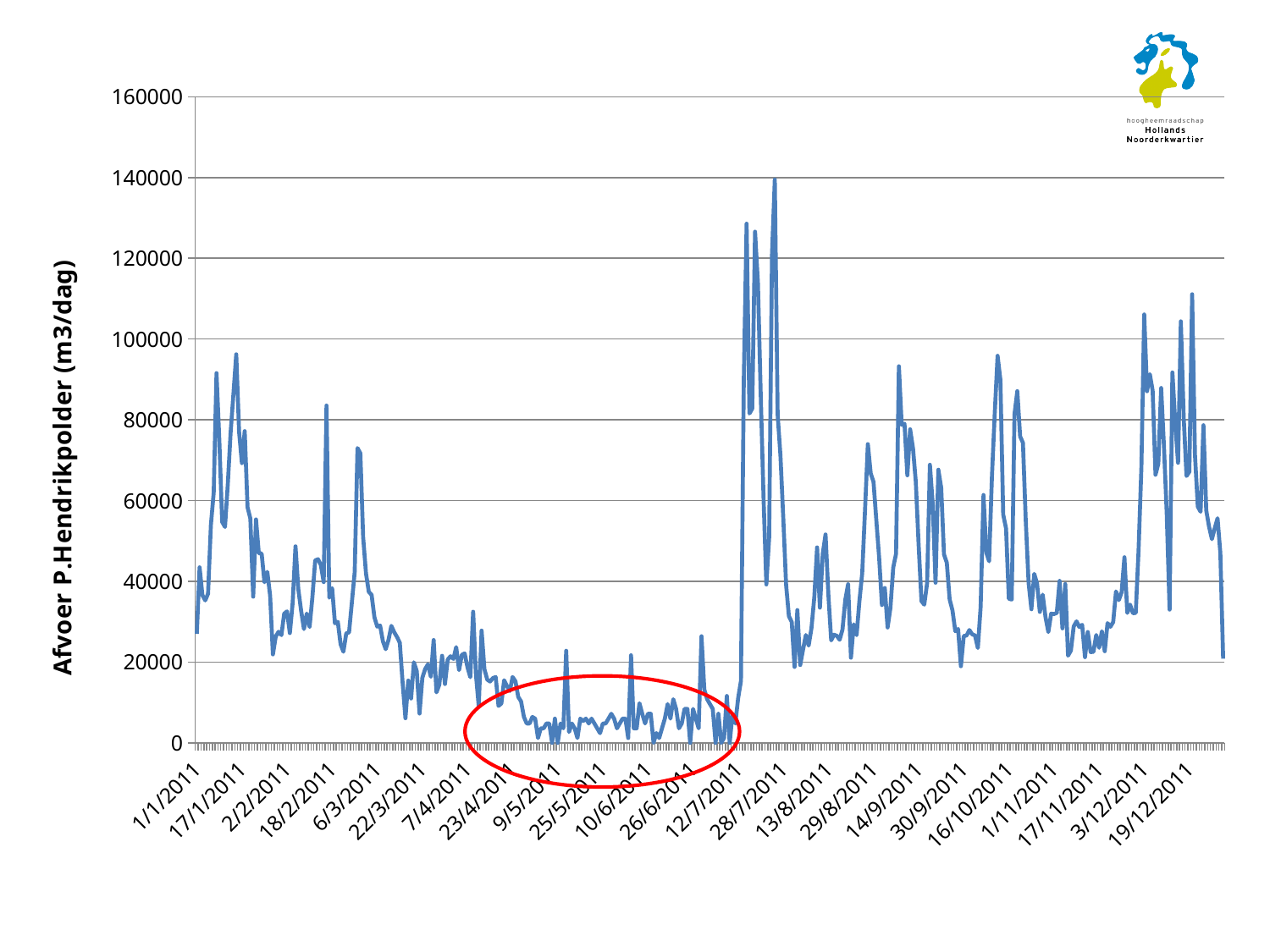
What kind of chart is shown on the slide? line chart Is the highest peak of the line greater or less than 120000? greater How many date labels are shown along the horizontal axis? 23 Is the value for 10/6/2011 greater or less than 20000? less Is the value for 25/5/2011 greater or less than 20000? less Does the line generally rise or fall between 1/1/2011 and 9/5/2011? fall What is the label of the vertical axis? Afvoer P.Hendrikpolder (m3/dag) What is the highest value shown on the vertical axis? 160000 Which is larger, the value around 9/5/2011 or the value around 28/7/2011? 28/7/2011